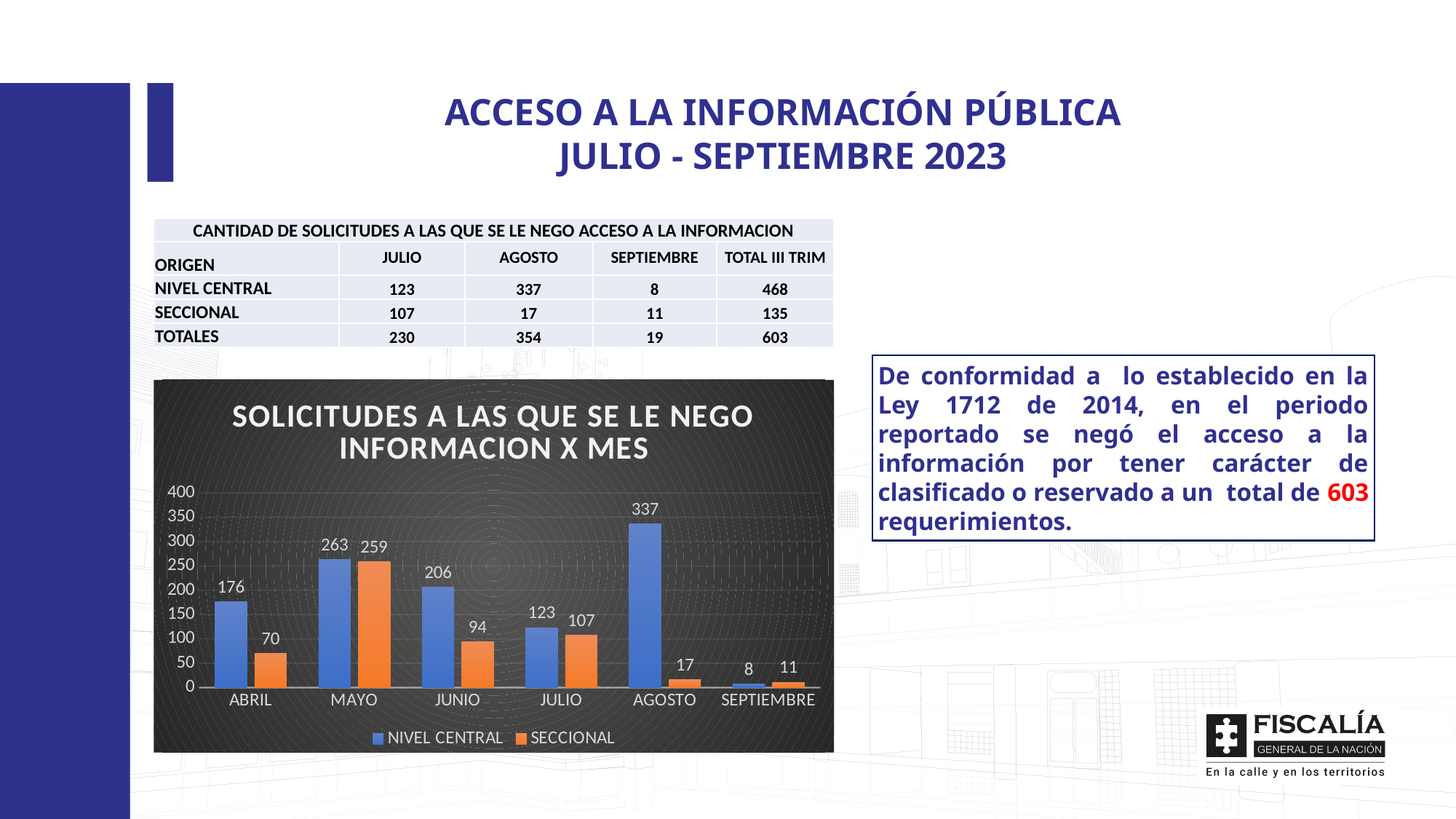
What is the value for SECCIONAL in ABRIL? 70 What is the title of the chart? SOLICITUDES A LAS QUE SE LE NEGO INFORMACION X MES What kind of chart is shown on the slide? Bar chart Which is larger in JUNIO, NIVEL CENTRAL or SECCIONAL? NIVEL CENTRAL Which month has the highest NIVEL CENTRAL value? AGOSTO How many months are shown on the x axis of the chart? 6 Which month has the lowest NIVEL CENTRAL value? SEPTIEMBRE What is the value for NIVEL CENTRAL in AGOSTO? 337 How many series does the chart legend list? 2 What is the value for SECCIONAL in MAYO? 259 Which colour represents the SECCIONAL series in the chart? Orange What is the difference between NIVEL CENTRAL and SECCIONAL in JULIO? 16